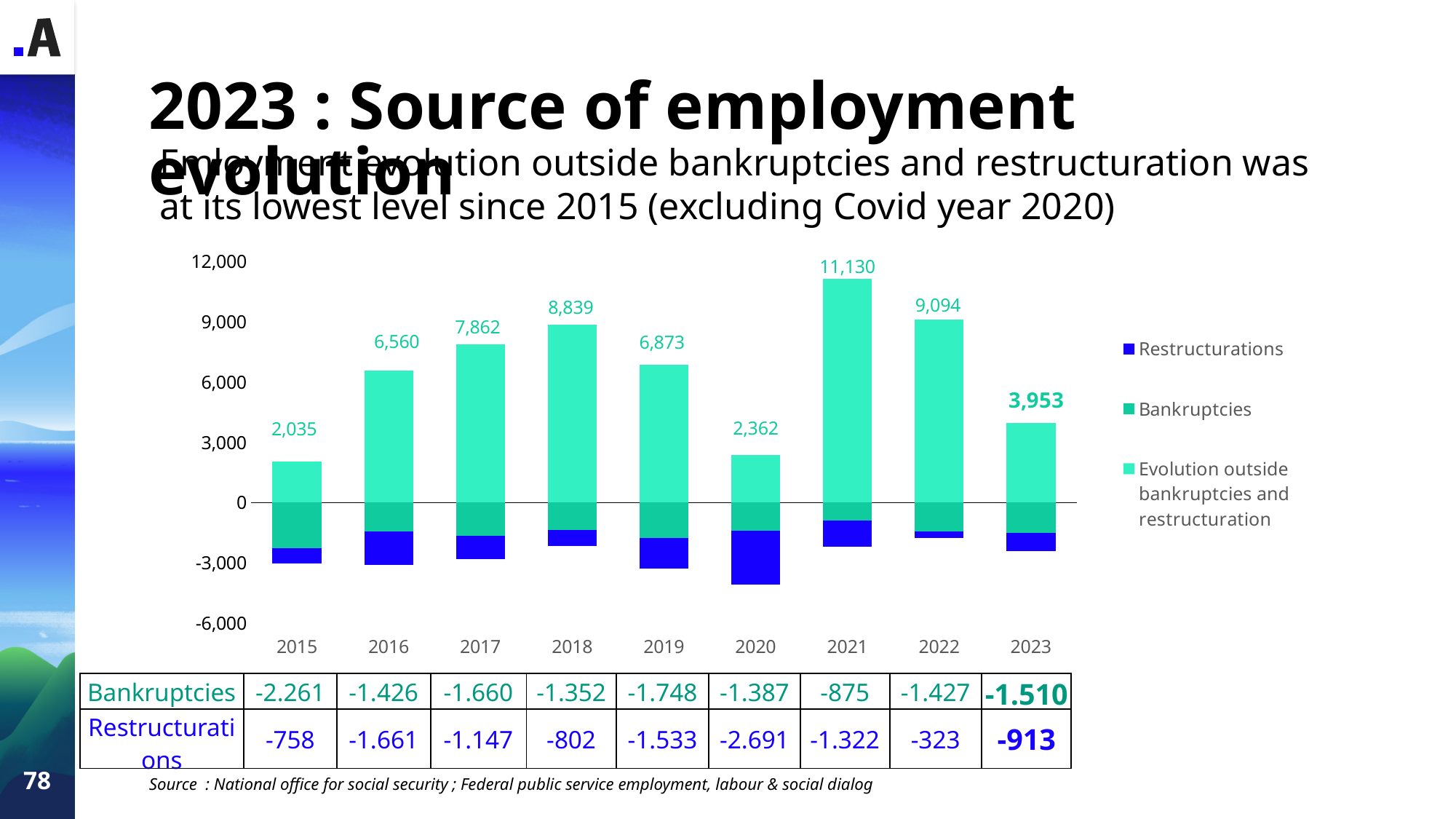
Which year has the highest value for Evolution outside bankruptcies and restructuration? 2021 What is the value of Evolution outside bankruptcies and restructuration for 2021? 11,130 What colour represents Restructurations in the chart legend? Blue What is the value of Evolution outside bankruptcies and restructuration for 2023? 3,953 What kind of chart is shown on the slide? Stacked bar chart Which year has the lowest value for Evolution outside bankruptcies and restructuration? 2015 How many series does the chart legend list? 3 What is the difference between the Evolution outside bankruptcies and restructuration values for 2022 and 2023? 5,141 What is the difference between the Evolution outside bankruptcies and restructuration values for 2021 and 2022? 2,036 Which year has the larger Evolution outside bankruptcies and restructuration value, 2017 or 2019? 2017 Is the Evolution outside bankruptcies and restructuration value for 2018 greater or less than 9,000? less How many years are shown on the x axis of the chart? 9